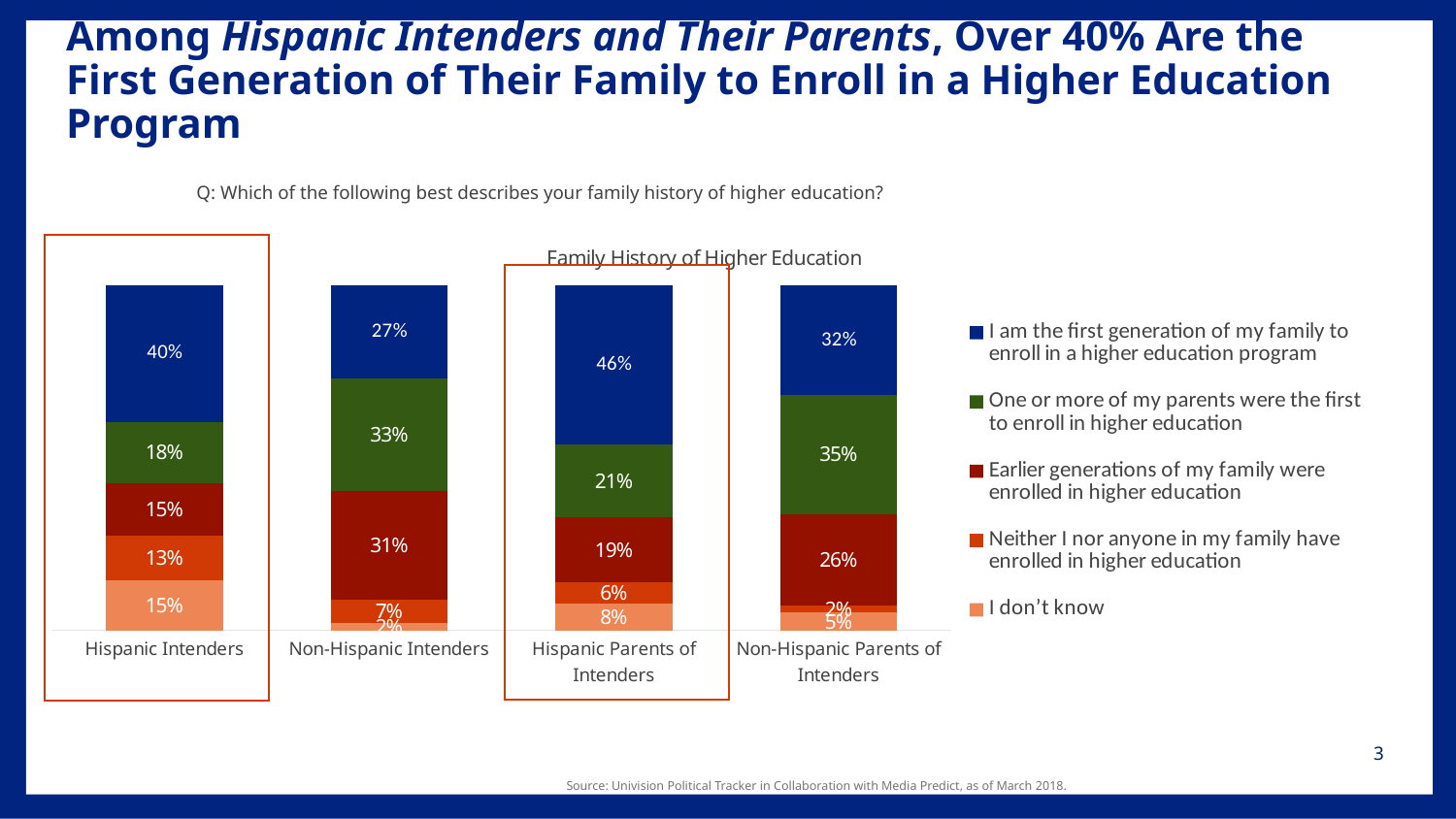
Which group has the highest share saying they are the first generation of their family to enroll in a higher education program? Hispanic Parents of Intenders What percentage of Hispanic Intenders say they are the first generation of their family to enroll in a higher education program? 40% What kind of chart is shown on the slide? Stacked bar chart What percentage of Hispanic Parents of Intenders say they are the first generation of their family to enroll in a higher education program? 46% What percentage of Hispanic Intenders answered 'I don't know'? 15% How many categories (groups) are shown along the x axis of the chart? 4 Which group has the lowest share saying they are the first generation of their family to enroll in a higher education program? Non-Hispanic Intenders What is the difference in percentage points between Hispanic Parents of Intenders and Hispanic Intenders for the 'first generation' response? 6 percentage points Which group has a larger share for 'One or more of my parents were the first to enroll in higher education': Hispanic Intenders or Non-Hispanic Intenders? Non-Hispanic Intenders What is the title of the chart? Family History of Higher Education What percentage of Non-Hispanic Parents of Intenders say earlier generations of their family were enrolled in higher education? 26% How many series does the chart's legend list? 5